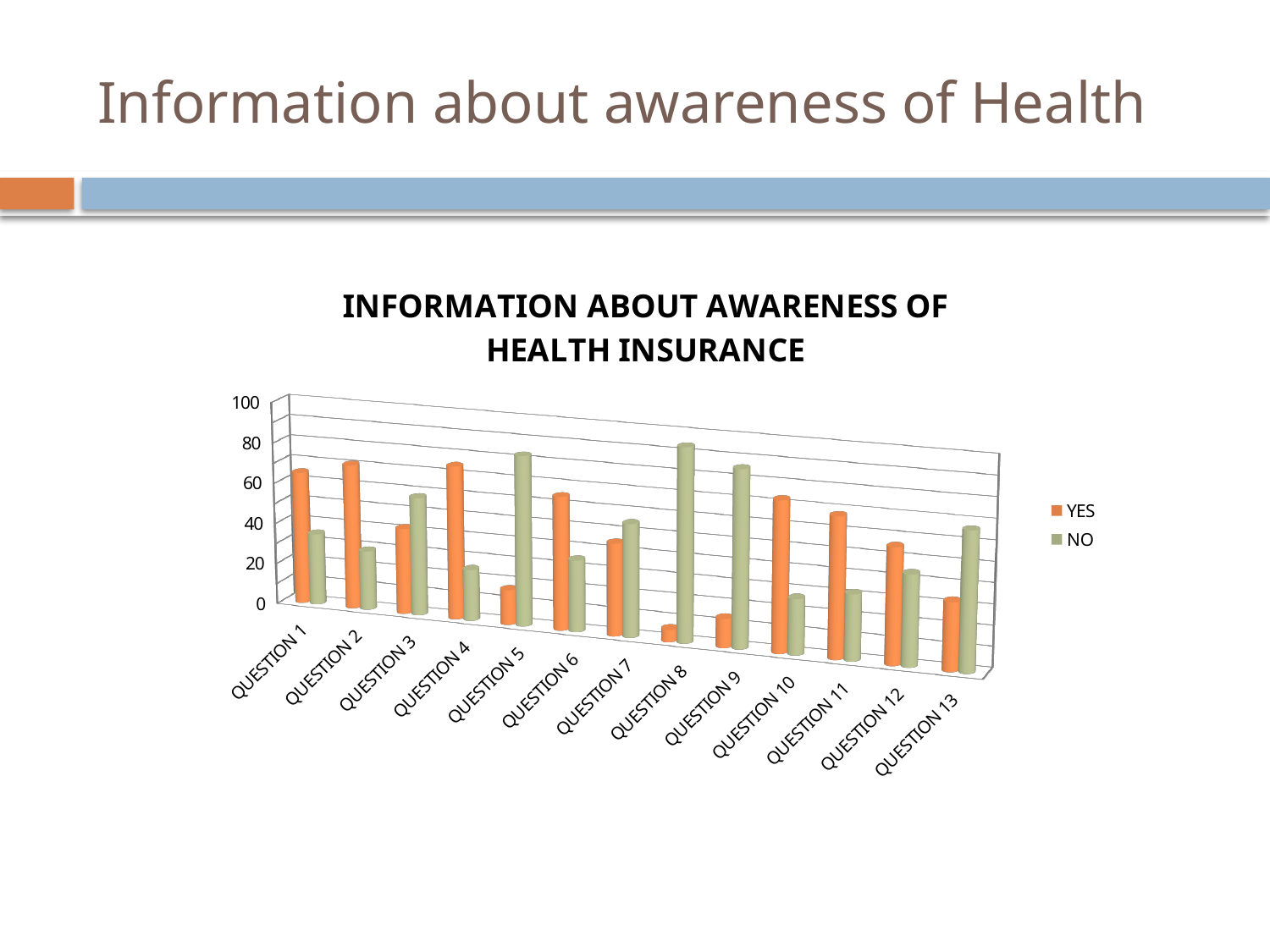
For which question is the NO value the highest? QUESTION 8 For which question is the YES value the lowest? QUESTION 8 What kind of chart is shown on the slide? bar chart How many questions (categories) are shown on the x axis of the chart? 13 For QUESTION 2, which is larger, the YES value or the NO value? YES For QUESTION 5, which is larger, the YES value or the NO value? NO For QUESTION 10, which is larger, the YES value or the NO value? YES How many series does the chart's legend list? 2 What is the title of the chart? INFORMATION ABOUT AWARENESS OF HEALTH INSURANCE What are the two series named in the chart's legend? YES and NO Is the NO value for QUESTION 8 greater or less than 60? greater Is the YES value for QUESTION 5 greater or less than 20? less